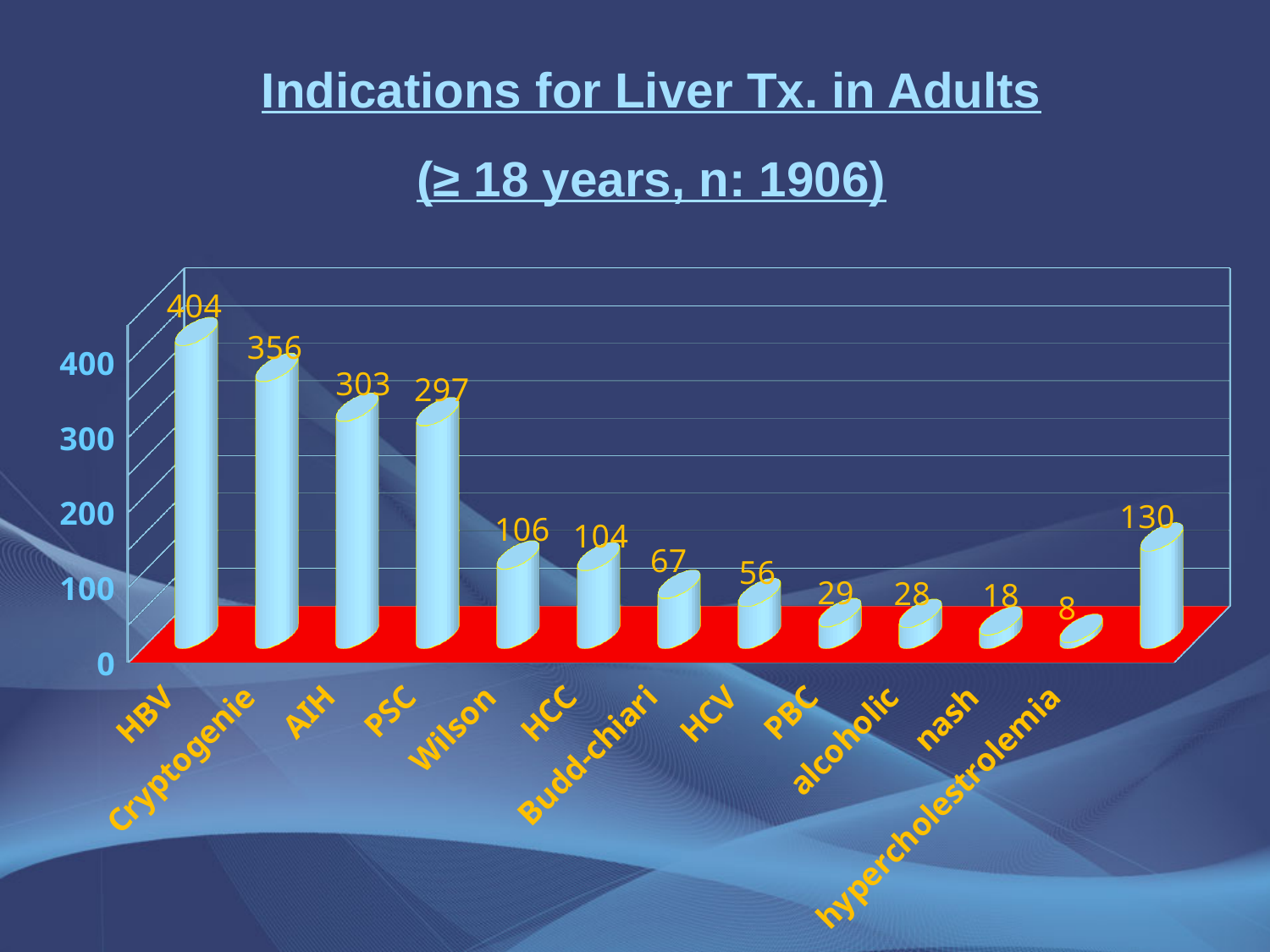
What is the value for nash? 18 What is the value for Wilson? 106 What kind of chart is shown on the slide? bar chart Which is larger, the value for HCV or the value for PBC? HCV Which category has the highest value? HBV How many bars are plotted in the chart? 13 What is the difference between the values for HBV and Cryptogenie? 48 What is the value for Budd-chiari? 67 Which category has the lowest value? hypercholestrolemia What is the title of the chart? Indications for Liver Tx. in Adults (≥ 18 years, n: 1906) What is the difference between the values for AIH and PSC? 6 What is the value for HBV? 404